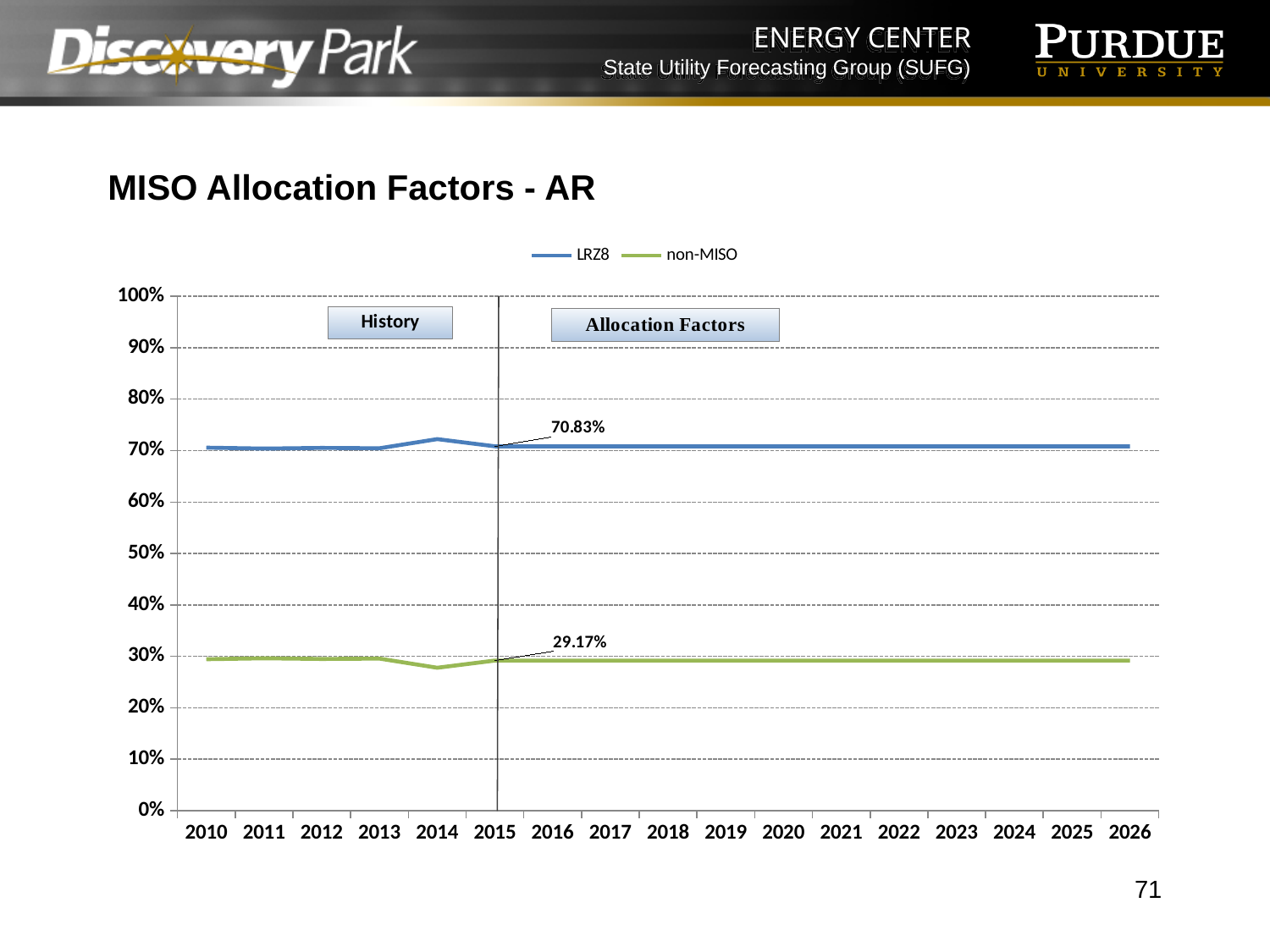
What is the difference between the labelled LRZ8 value (70.83%) and the labelled non-MISO value (29.17%) at 2015? 41.66% What is the title of the chart on the slide? MISO Allocation Factors - AR Is the value for LRZ8 in 2020 greater or less than 60%? greater What is the total of the labelled LRZ8 and non-MISO values at 2015? 100% What is the labelled value of the non-MISO series at 2015? 29.17% What colour is the line for the non-MISO series? green Which series has the higher values, LRZ8 or non-MISO? LRZ8 Is the value for non-MISO in 2014 greater or less than 30%? less How many years are shown on the x axis? 17 How many series does the legend list? 2 What kind of chart is shown on the slide? line chart What is the labelled value of the LRZ8 series at 2015? 70.83%